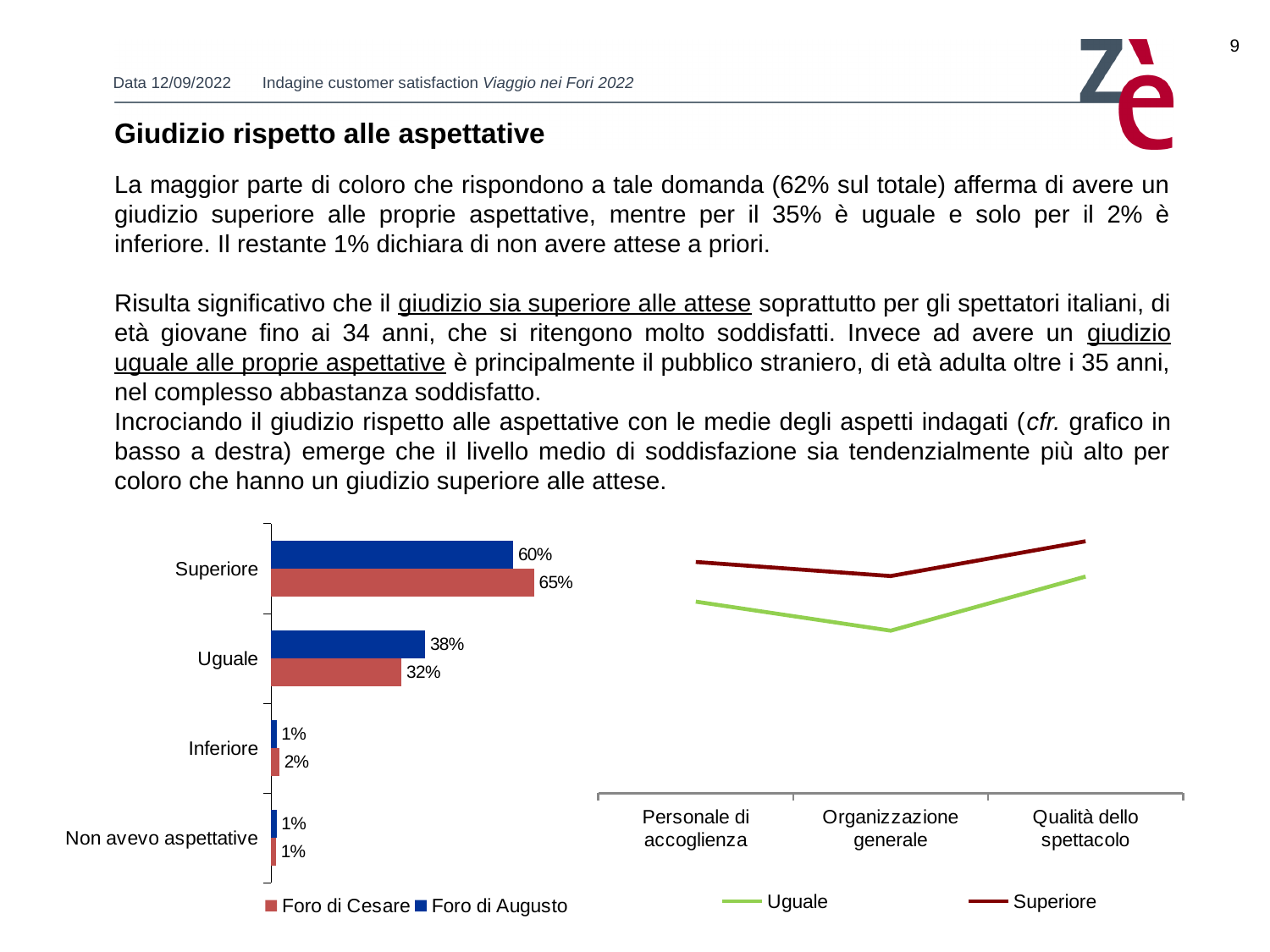
In the line chart on the right, which series is higher at Qualità dello spettacolo: Uguale or Superiore? Superiore How many series does the legend of the bar chart on the left list? 2 In the bar chart on the left, what is the value for Foro di Cesare in the Inferiore category? 2% In the bar chart on the left, which category has the highest value for Foro di Augusto? Superiore In the line chart on the right, at which category does the Uguale line reach its lowest point? Organizzazione generale In the bar chart on the left, what is the value for Foro di Cesare in the Superiore category? 65% In the bar chart on the left, what is the difference between Foro di Cesare and Foro di Augusto in the Superiore category? 5% What kind of chart is the chart on the right of the slide? Line chart In the bar chart on the left, which is larger in the Uguale category: Foro di Cesare or Foro di Augusto? Foro di Augusto How many categories does the bar chart on the left show? 4 In the bar chart on the left, what is the value for Foro di Augusto in the Uguale category? 38% In the bar chart on the left, what is the difference between Foro di Augusto and Foro di Cesare in the Uguale category? 6%